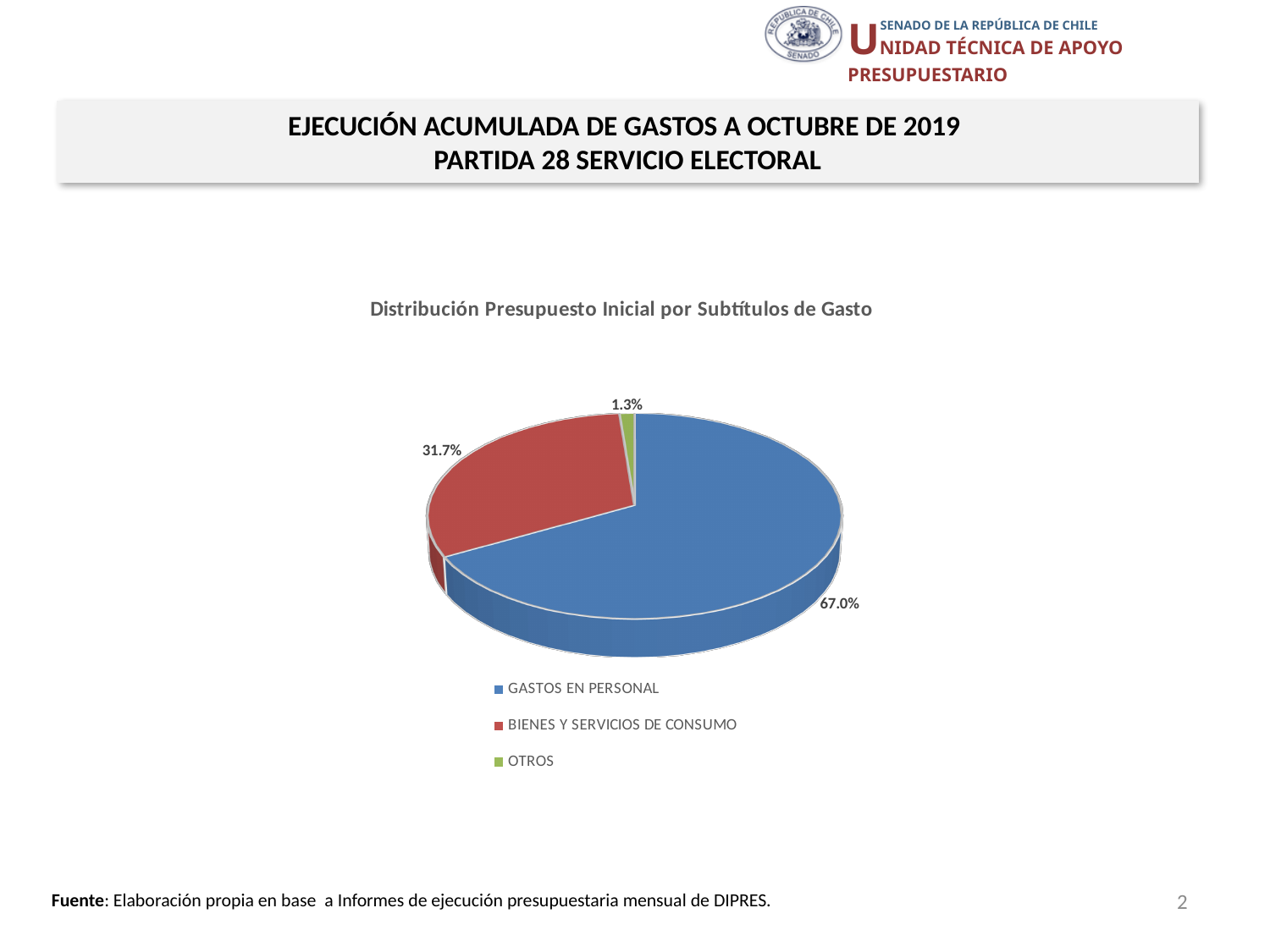
What share of the pie does BIENES Y SERVICIOS DE CONSUMO represent? 31.7% What share of the pie does OTROS represent? 1.3% Which category has the smallest share of the pie? OTROS Which is larger, the share for BIENES Y SERVICIOS DE CONSUMO or the share for OTROS? BIENES Y SERVICIOS DE CONSUMO What is the title of the chart? Distribución Presupuesto Inicial por Subtítulos de Gasto What share of the pie does GASTOS EN PERSONAL represent? 67.0% Which category has the largest share of the pie? GASTOS EN PERSONAL What is the difference in percentage points between GASTOS EN PERSONAL and BIENES Y SERVICIOS DE CONSUMO? 35.3 What colour is the slice for OTROS? Green How many entries does the legend list? 3 What type of chart is shown on the slide? Pie chart How many categories does the pie chart show? 3